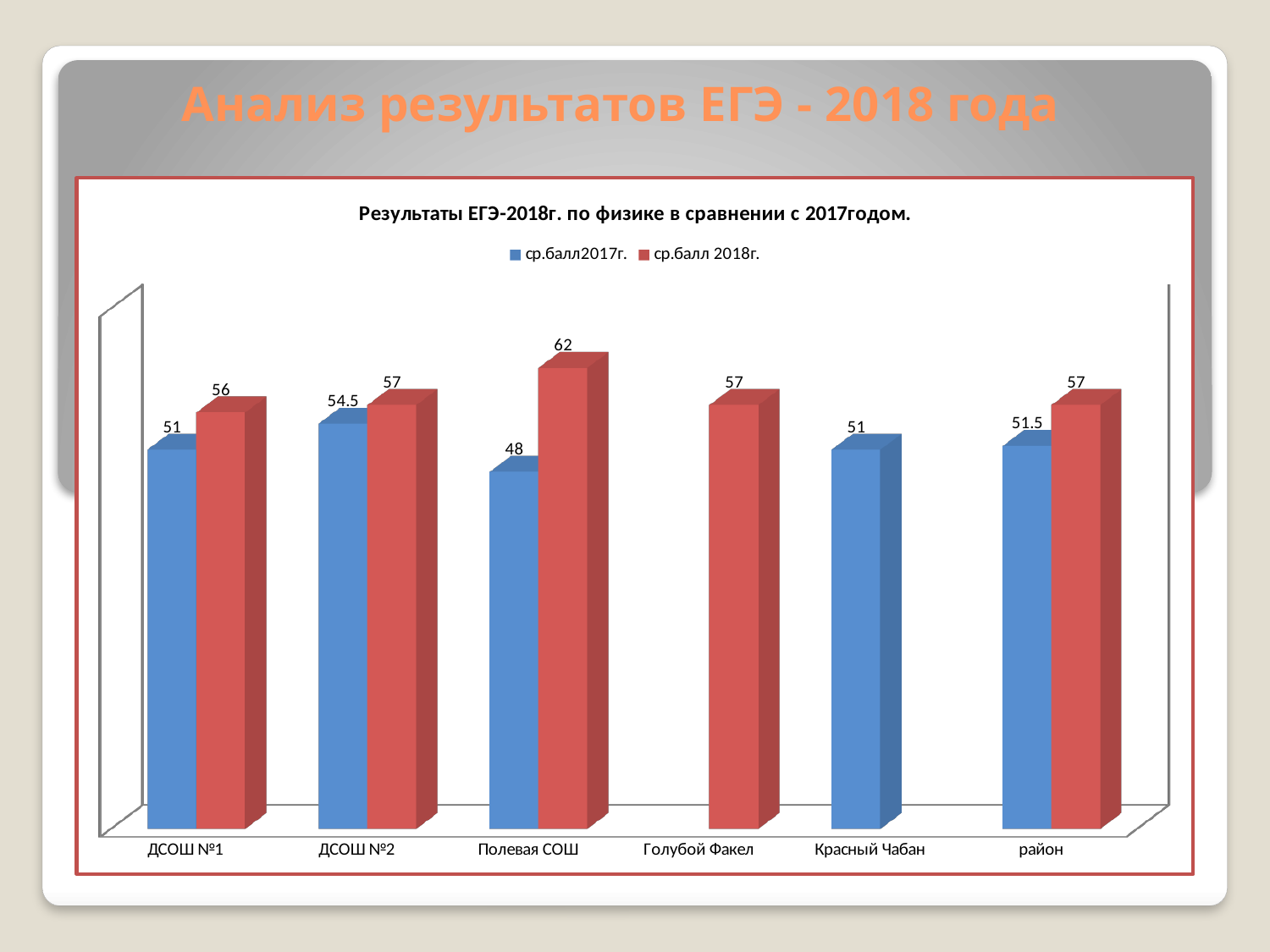
What is the value of ср.балл 2018г. for Полевая СОШ? 62 What is the value of ср.балл2017г. for район? 51.5 What is the value of ср.балл 2018г. for Голубой Факел? 57 How many categories are shown on the x axis? 6 What kind of chart is shown on the slide? bar chart What is the value of ср.балл2017г. for ДСОШ №2? 54.5 What is the difference between ср.балл 2018г. and ср.балл2017г. for ДСОШ №1? 5 What is the difference between ср.балл 2018г. and ср.балл2017г. for Полевая СОШ? 14 Which category has the highest value for ср.балл 2018г.? Полевая СОШ Which category has the lowest value for ср.балл2017г.? Полевая СОШ Which is larger for ДСОШ №2: ср.балл2017г. or ср.балл 2018г.? ср.балл 2018г. How many series does the legend list? 2